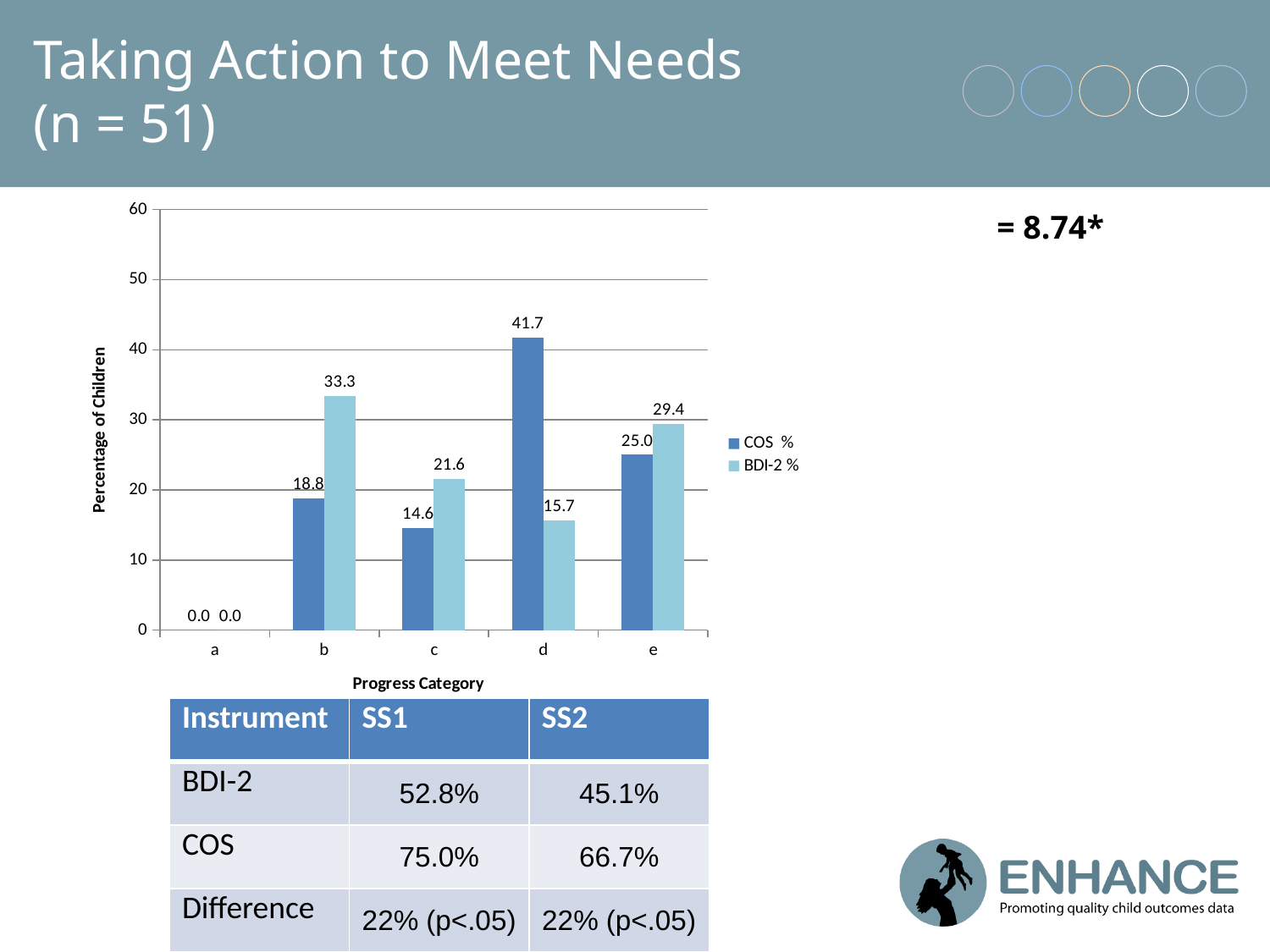
What kind of chart is shown on the slide? bar chart Which progress category has the lowest BDI-2 % value? a How many progress categories are shown on the x axis? 5 What is the COS % value for progress category e? 25.0 What is the BDI-2 % value for progress category b? 33.3 What is the COS % value for progress category d? 41.7 For progress category c, which series has the larger value, COS % or BDI-2 %? BDI-2 % What is the difference between the COS % and BDI-2 % values for progress category d? 26.0 Is the COS % value for progress category d greater or less than 40? greater Which progress category has the highest COS % value? d Which progress category has the highest BDI-2 % value? b How many series does the legend list? 2